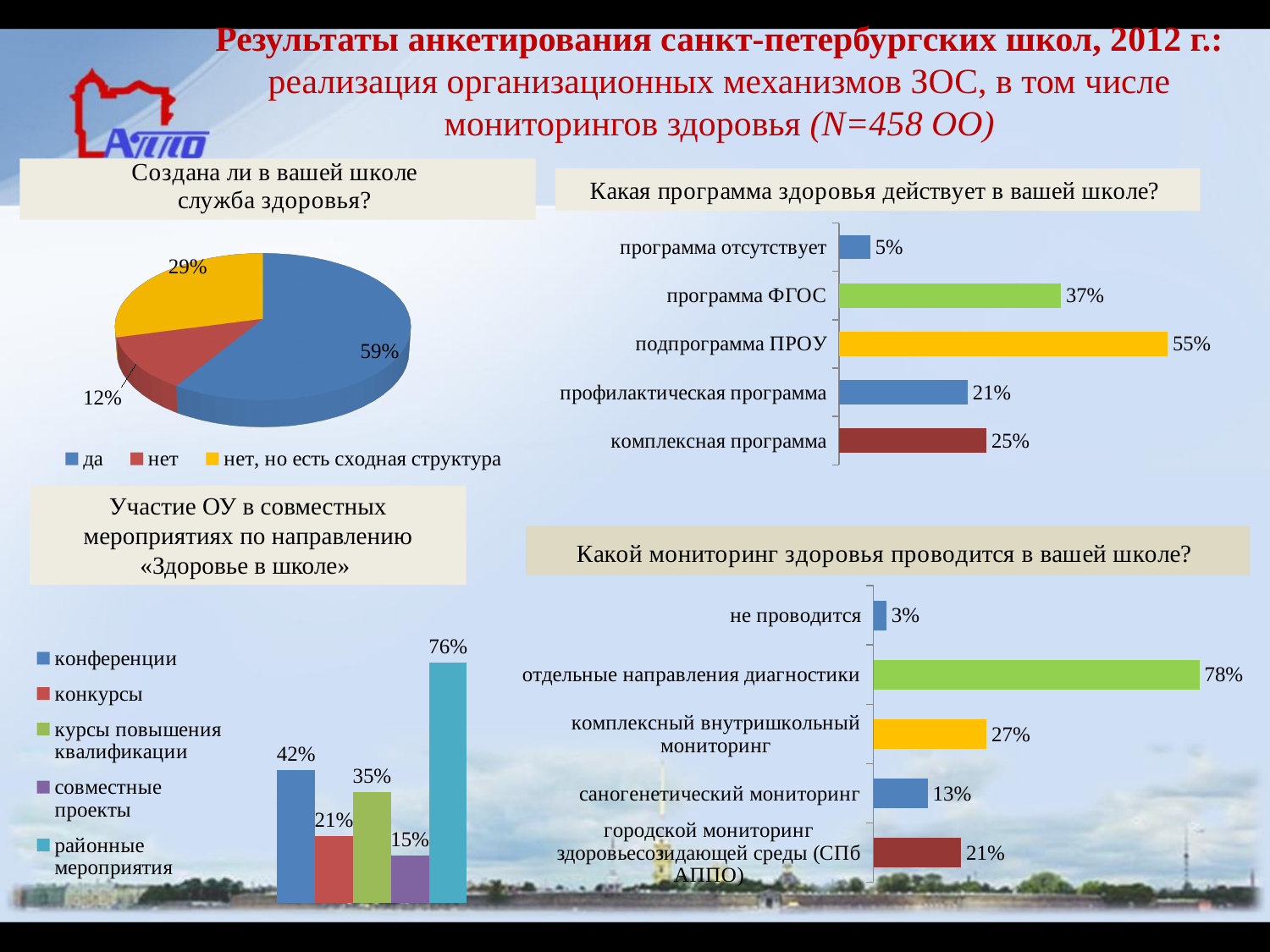
In the pie chart 'Создана ли в вашей школе служба здоровья?', what share of schools answered 'да'? 59% In the chart 'Какая программа здоровья действует в вашей школе?', how many categories are shown? 5 In the chart 'Какая программа здоровья действует в вашей школе?', what is the value for 'подпрограмма ПРОУ'? 55% In the pie chart 'Создана ли в вашей школе служба здоровья?', how many entries does the legend list? 3 In the chart 'Какой мониторинг здоровья проводится в вашей школе?', what is the value for 'комплексный внутришкольный мониторинг'? 27% In the chart 'Участие ОУ в совместных мероприятиях по направлению «Здоровье в школе»', which is larger: 'конференции' or 'курсы повышения квалификации'? конференции In the chart 'Участие ОУ в совместных мероприятиях по направлению «Здоровье в школе»', which series has the lowest value? совместные проекты In the chart 'Какая программа здоровья действует в вашей школе?', what is the difference between 'программа ФГОС' and 'комплексная программа'? 12% In the pie chart 'Создана ли в вашей школе служба здоровья?', what share corresponds to 'нет, но есть сходная структура'? 29% What kind of chart is 'Какой мониторинг здоровья проводится в вашей школе?'? bar chart In the chart 'Какая программа здоровья действует в вашей школе?', which category has the lowest value? программа отсутствует In the chart 'Участие ОУ в совместных мероприятиях по направлению «Здоровье в школе»', what is the value for 'районные мероприятия'? 76%